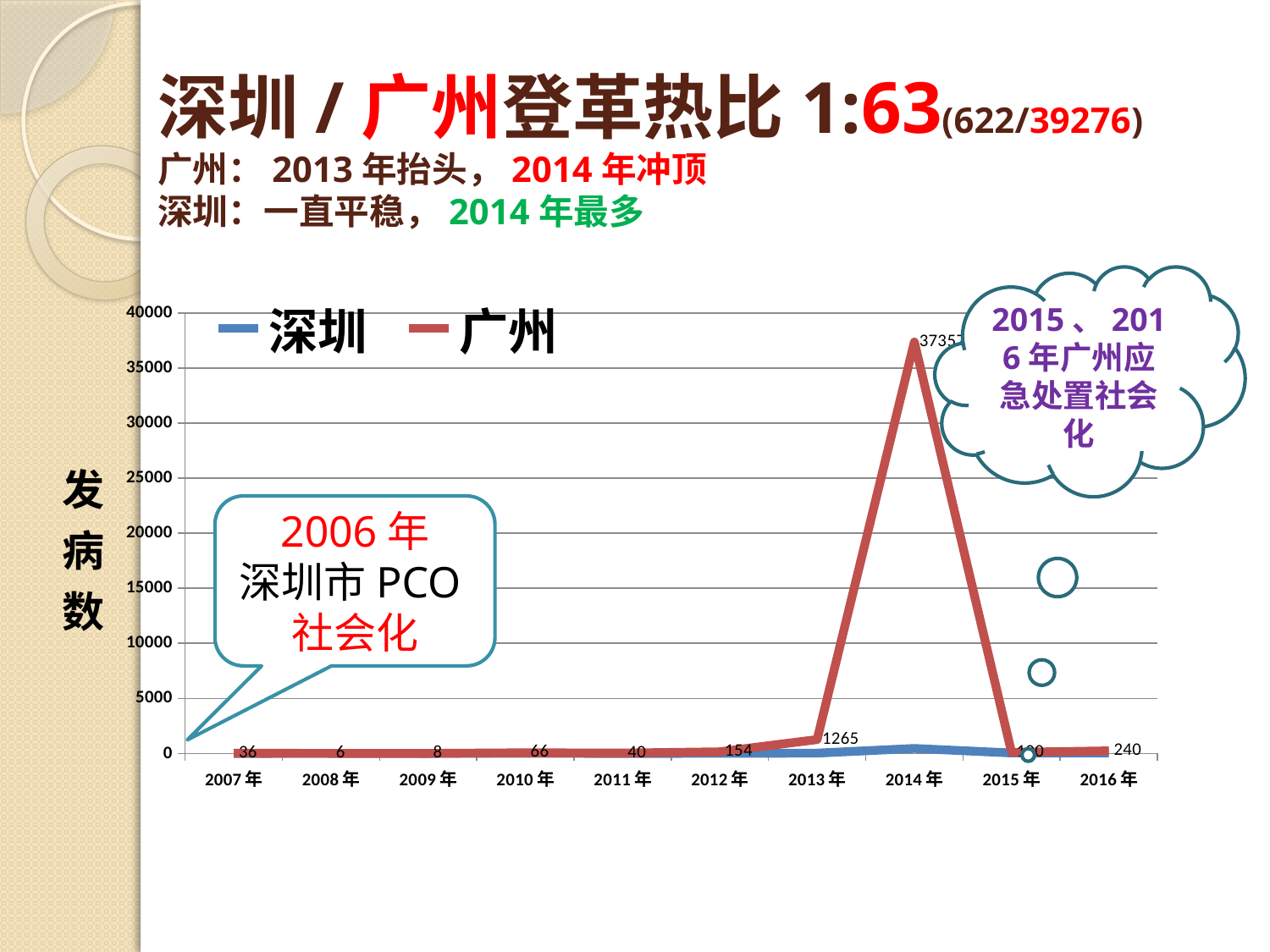
In which year does the 广州 line reach its highest value? 2014年 Which colour represents 广州 in the chart legend? red How many years are shown on the x axis of the chart? 10 What is the difference between the 广州 values for 2013年 (1265) and 2012年 (154)? 1111 Which is larger for 广州: the value in 2013年 or the value in 2012年? 2013年 What is the data label shown for 广州 at 2007年? 36 Is the value for 广州 in 2014年 greater or less than 35000? greater How many series does the chart legend list? 2 What kind of chart is shown on the slide? line chart What is the data label shown for 广州 at 2012年? 154 What is the data label shown for 广州 at 2013年? 1265 What is the data label shown for 广州 at 2016年? 240